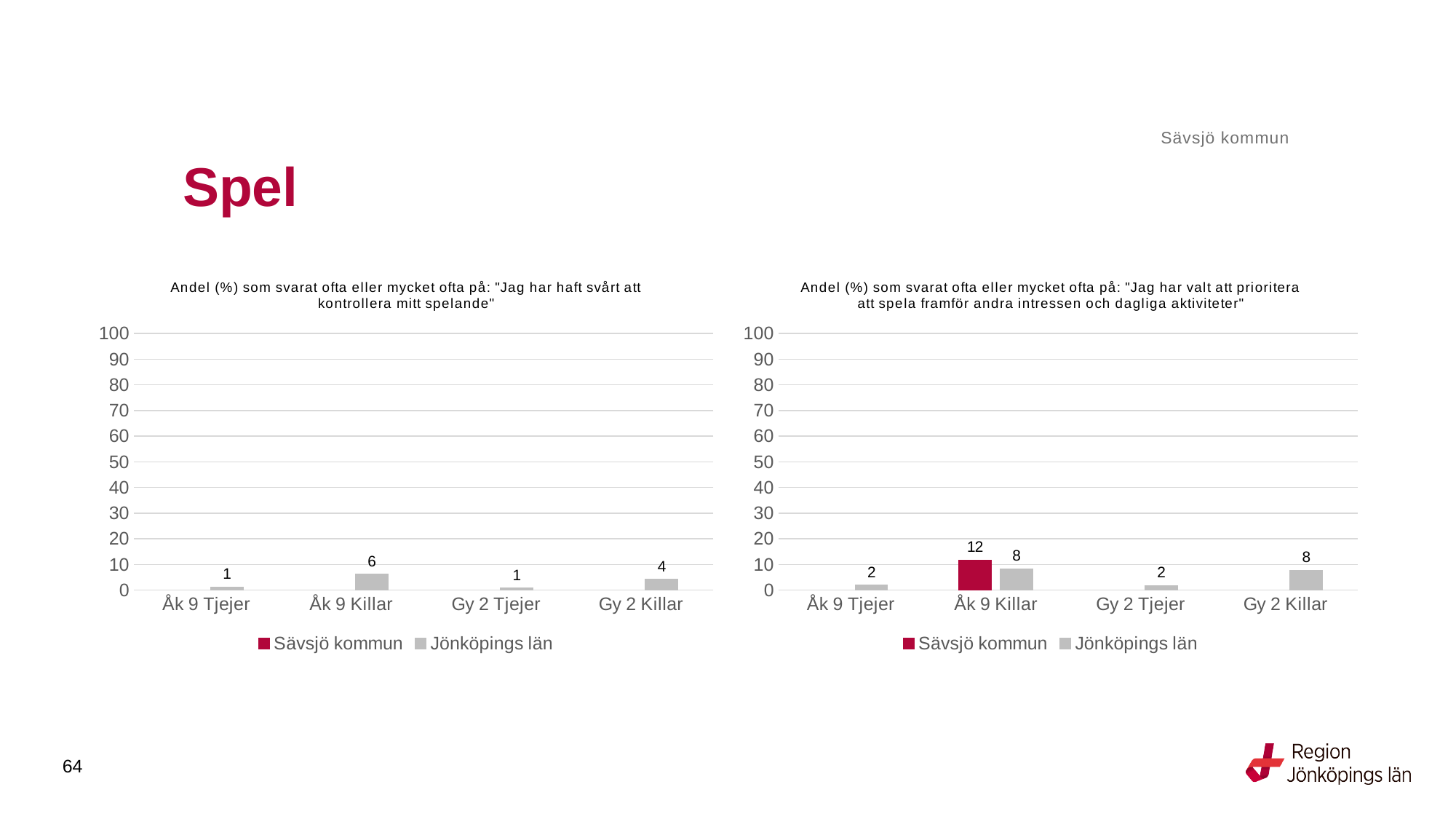
In the right chart, what is the value for Jönköpings län for Gy 2 Tjejer? 2 In the right chart, is the value for Sävsjö kommun for Åk 9 Killar greater or less than 10? greater In the left chart, what is the value for Jönköpings län for Gy 2 Killar? 4 In the left chart, what is the difference between the Jönköpings län values for Åk 9 Killar and Gy 2 Killar? 2 In the right chart, what is the difference between Sävsjö kommun and Jönköpings län for Åk 9 Killar? 4 In the right chart, for Åk 9 Killar, which is larger: Sävsjö kommun or Jönköpings län? Sävsjö kommun In the right chart, what is the value for Sävsjö kommun for Åk 9 Killar? 12 How many categories are shown on the x axis of the right chart? 4 What type of chart is the right chart? Bar chart How many series does the legend of the left chart list? 2 In the left chart, which category has the highest Jönköpings län value? Åk 9 Killar In the left chart, what is the value for Jönköpings län for Åk 9 Killar? 6